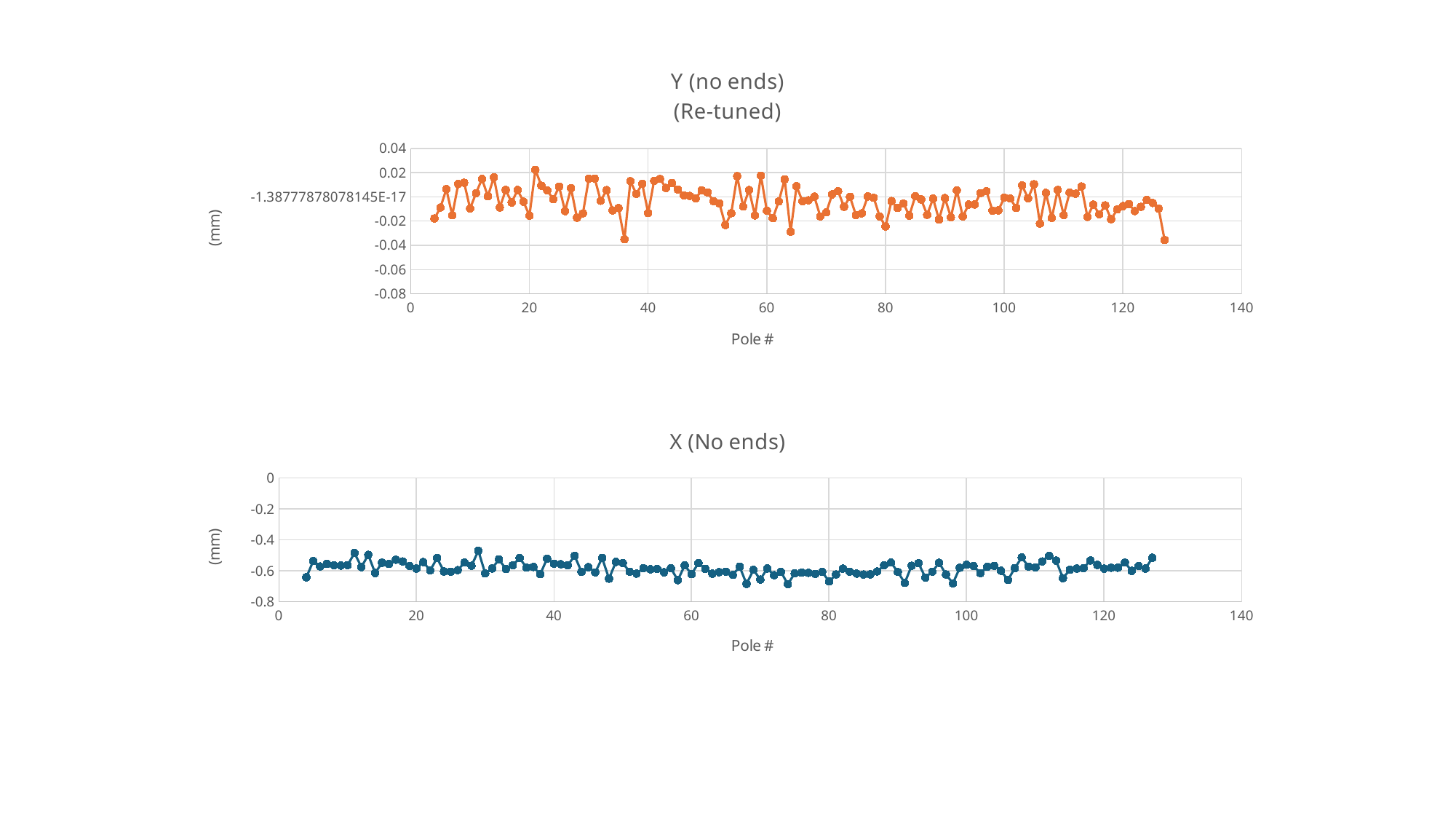
In the bottom chart "X (No ends)", is the value at pole 29 greater or less than -0.6? greater What kind of chart is the bottom chart titled "X (No ends)"? line chart In the bottom chart "X (No ends)", are all plotted values greater than -0.8? Yes In the top chart "Y (no ends) (Re-tuned)", are any plotted values greater than 0.04? No What is the title of the bottom chart? X (No ends) What kind of chart is the top chart titled "Y (no ends) (Re-tuned)"? line chart What is the x-axis label on the top chart "Y (no ends) (Re-tuned)"? Pole #